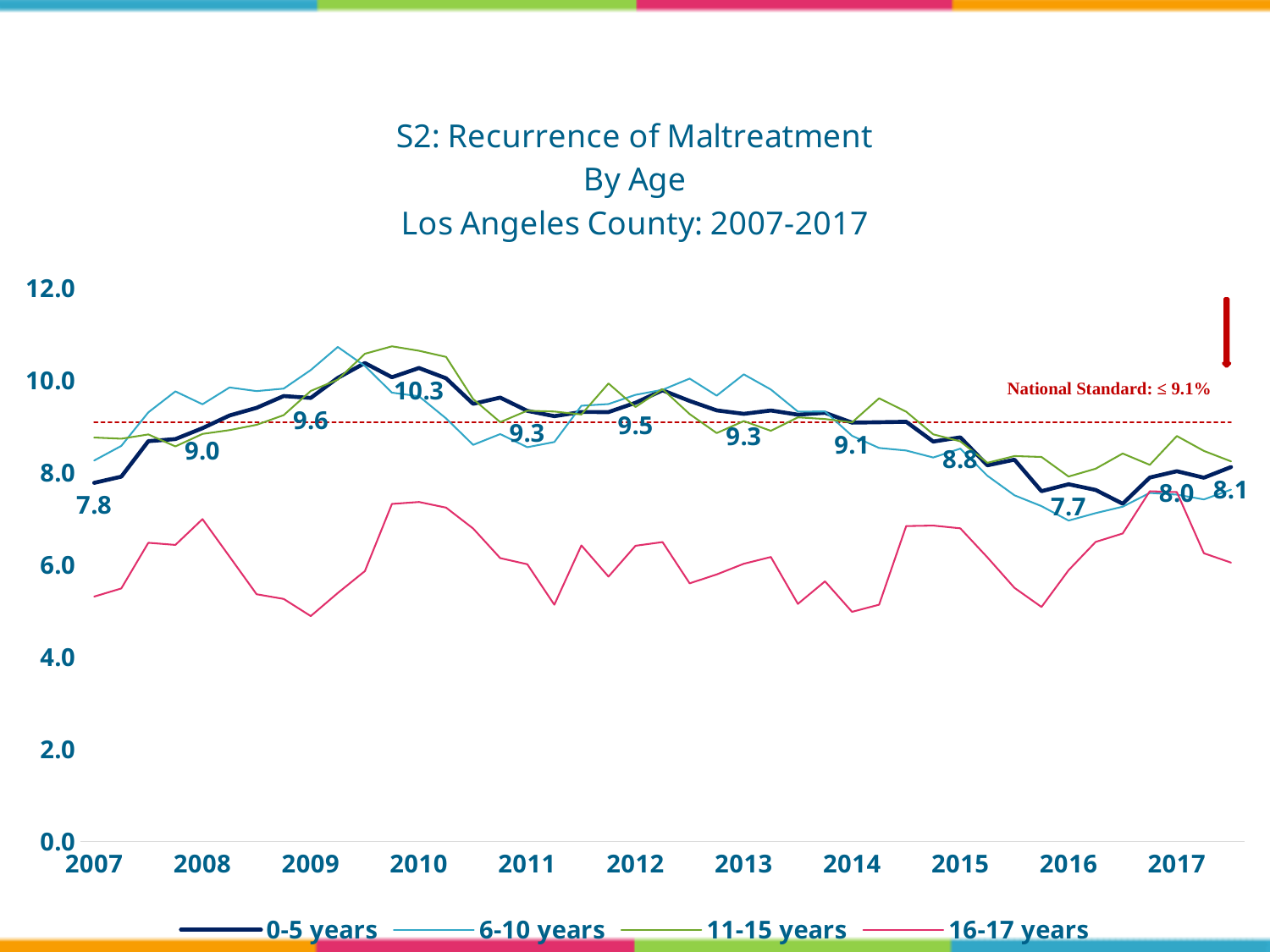
In which year does the 0-5 years series have its lowest labeled value? 2016 In which year does the 0-5 years series reach its highest labeled value? 2010 What is the labeled value for the 0-5 years series in 2007? 7.8 What is the difference between the 0-5 years values in 2010 and 2016? 2.6 What type of chart is shown on the slide? line chart What National Standard value is shown by the dashed line? ≤ 9.1% How many series does the legend list? 4 Which series is the lowest across the whole period? 16-17 years What is the labeled value for the 0-5 years series in 2010? 10.3 Which is larger for the 0-5 years series: the value in 2007 or the value in 2010? 2010 What is the labeled value for the 0-5 years series in 2016? 7.7 Is the value for the 16-17 years series in 2007 greater or less than 6.0? less